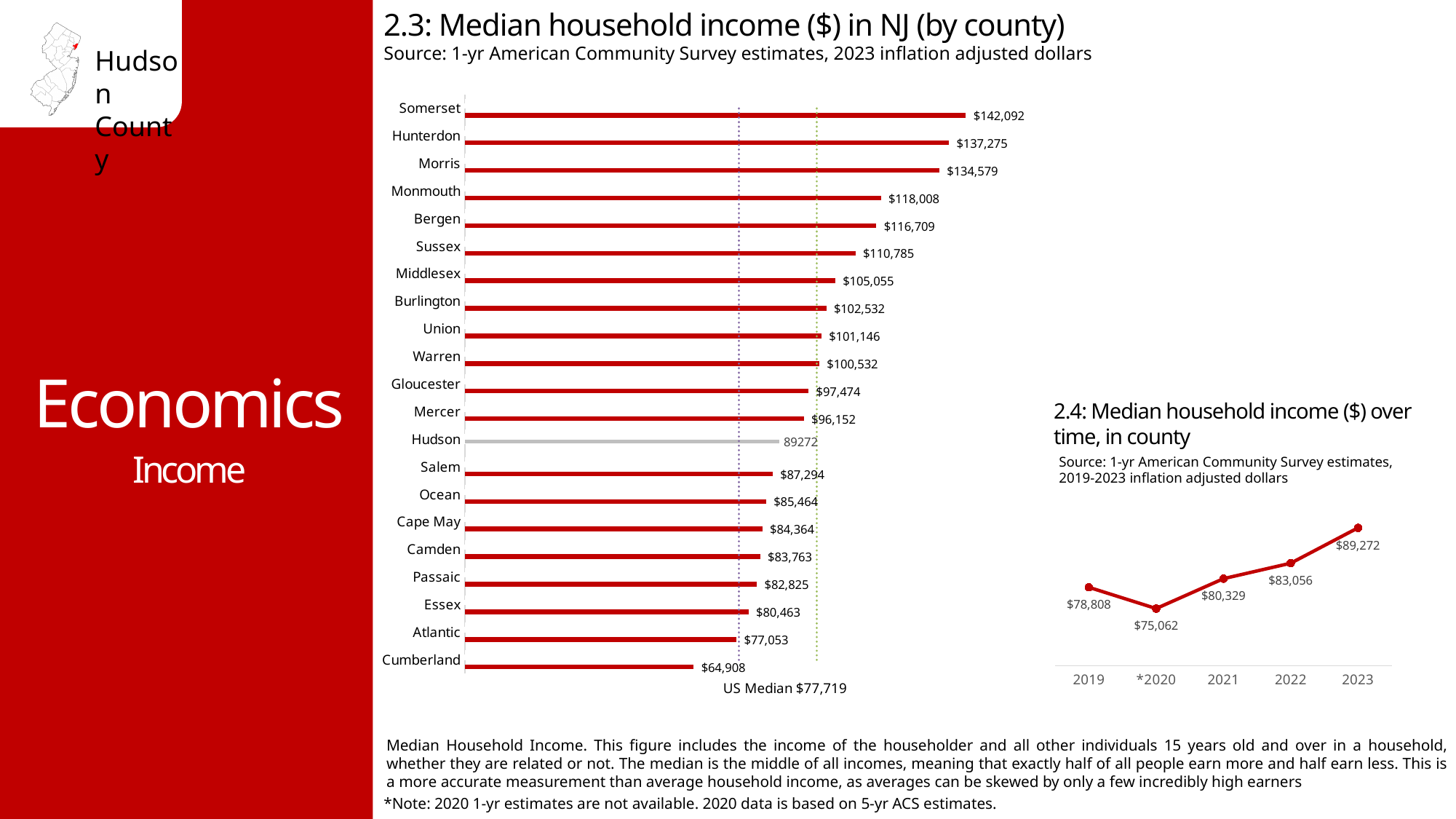
In chart 2.3 (Median household income in NJ by county), which county has the highest median household income? Somerset What kind of chart is chart 2.3 (Median household income in NJ by county)? Bar chart In chart 2.3 (Median household income in NJ by county), which county has the lowest median household income? Cumberland In chart 2.3 (Median household income in NJ by county), what value is shown for Hudson? 89272 In chart 2.4 (Median household income over time, in county), what is the value for 2023? $89,272 In chart 2.4 (Median household income over time, in county), which year has the lowest value? *2020 In chart 2.3 (Median household income in NJ by county), what is the median household income for Somerset? $142,092 In chart 2.4 (Median household income over time, in county), how many data points are plotted? 5 In chart 2.3 (Median household income in NJ by county), which has a higher median household income, Bergen or Sussex? Bergen In chart 2.4 (Median household income over time, in county), what is the difference between the 2023 and 2019 values? $10,464 In chart 2.3 (Median household income in NJ by county), how many counties are plotted? 21 In chart 2.3 (Median household income in NJ by county), what is the difference between Somerset and Hunterdon? $4,817